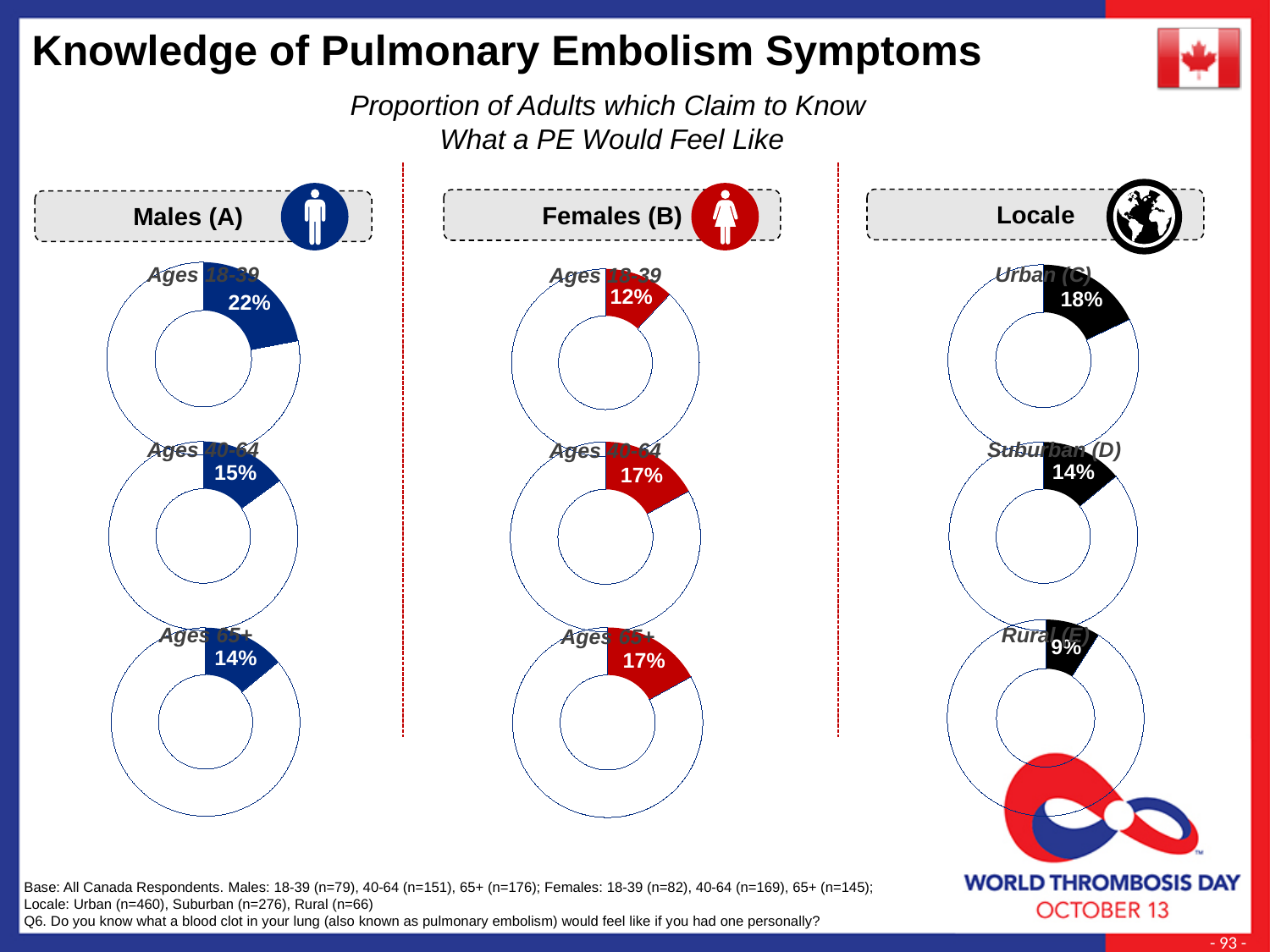
In the Females (B) column, what is the value shown for Ages 18-39? 12% What colour are the highlighted slices in the Females (B) column? Red In the Locale column, which locale has the lowest proportion? Rural (E) What is the difference between the Males (A) Ages 18-39 value and the Females (B) Ages 18-39 value? 10 percentage points What type of chart is used to show each proportion on this slide? Donut (pie) chart In the Males (A) column, which age group has the highest proportion? Ages 18-39 How many donut charts are shown in the Locale column? 3 What is the difference between the Urban (C) and Suburban (D) values in the Locale column? 4 percentage points In the Locale column, what is the value shown for Urban (C)? 18% In the Locale column, what is the value shown for Rural (E)? 9% In the Males (A) column, what proportion of adults aged 18-39 claim to know what a PE would feel like? 22% Which is larger: the Males (A) Ages 40-64 value or the Females (B) Ages 40-64 value? Females (B) Ages 40-64